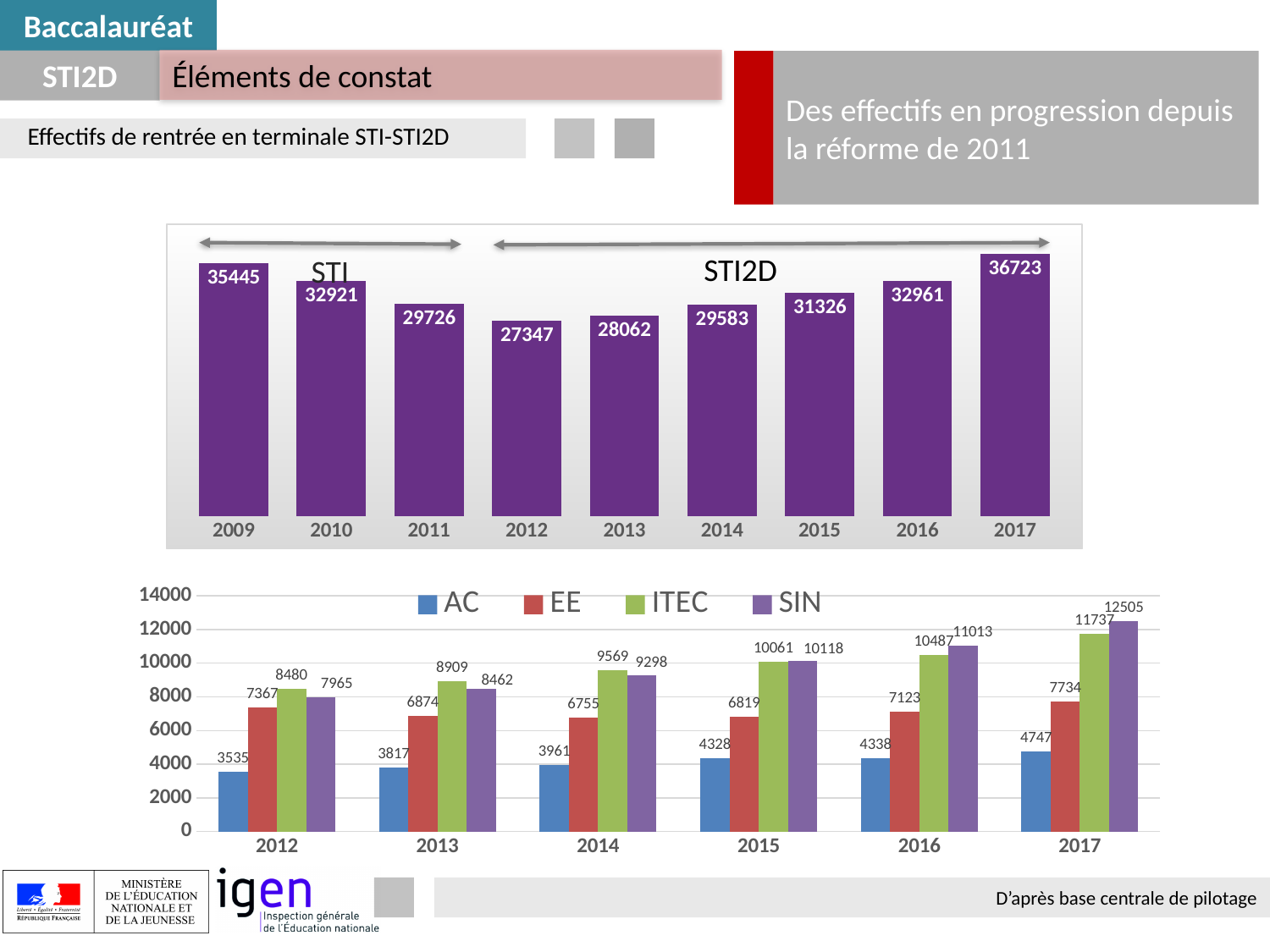
In the bottom chart, which is larger in 2013: EE or ITEC? ITEC In the top chart, which year has the lowest value? 2012 In the bottom chart, what is the value for AC in 2014? 3961 In the top chart, what is the difference between the values for 2017 and 2012? 9376 In the top chart, how many years are shown on the x axis? 9 In the top chart, do the values rise or fall from 2012 to 2017? rise What kind of chart is the bottom chart? bar chart In the bottom chart, what is the difference between SIN and ITEC in 2017? 768 In the bottom chart, what is the value for SIN in 2017? 12505 In the top chart, which year has the highest value? 2017 In the bottom chart, how many series does the legend list? 4 In the top chart, what is the value for 2012? 27347